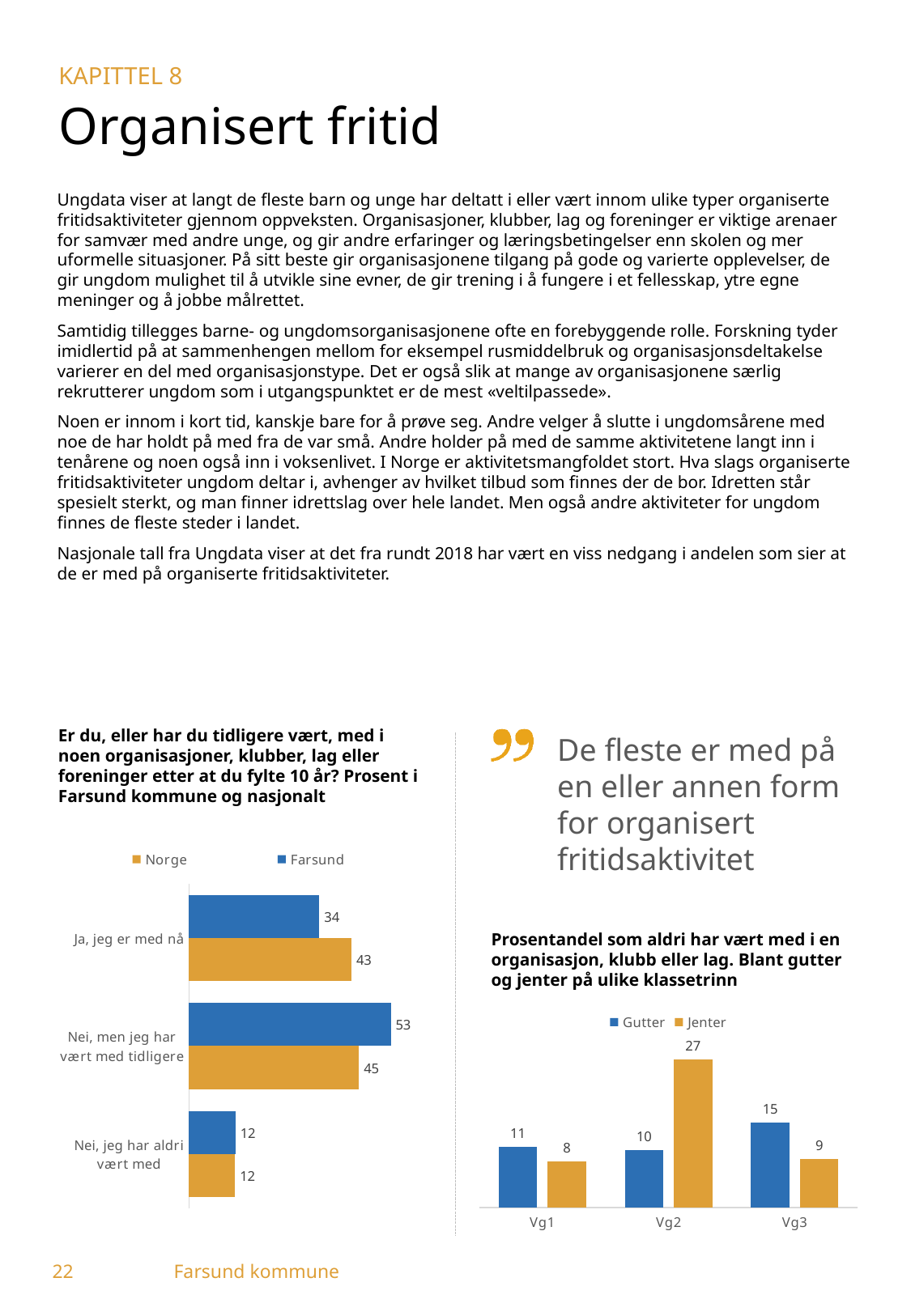
In the left chart (Er du, eller har du tidligere vært, med i noen organisasjoner...), which category has the highest Farsund value? Nei, men jeg har vært med tidligere In the left chart (Er du, eller har du tidligere vært, med i noen organisasjoner...), how many series does the legend list? 2 In the left chart (Er du, eller har du tidligere vært, med i noen organisasjoner...), what kind of chart is shown? Bar chart In the right chart (Prosentandel som aldri har vært med i en organisasjon...), which class level has the lowest Jenter value? Vg1 In the right chart (Prosentandel som aldri har vært med i en organisasjon...), what is the Jenter value for Vg2? 27 In the left chart (Er du, eller har du tidligere vært, med i noen organisasjoner...), what is the Farsund value for 'Ja, jeg er med nå'? 34 In the right chart (Prosentandel som aldri har vært med i en organisasjon...), what is the Gutter value for Vg3? 15 In the left chart (Er du, eller har du tidligere vært, med i noen organisasjoner...), what is the Norge value for 'Nei, men jeg har vært med tidligere'? 45 In the left chart (Er du, eller har du tidligere vært, med i noen organisasjoner...), what is the difference between the Norge and Farsund values for 'Ja, jeg er med nå'? 9 In the right chart (Prosentandel som aldri har vært med i en organisasjon...), which is larger for Vg1: Gutter or Jenter? Gutter In the right chart (Prosentandel som aldri har vært med i en organisasjon...), how many class levels are shown on the x axis? 3 In the right chart (Prosentandel som aldri har vært med i en organisasjon...), what is the difference between the Jenter and Gutter values for Vg2? 17